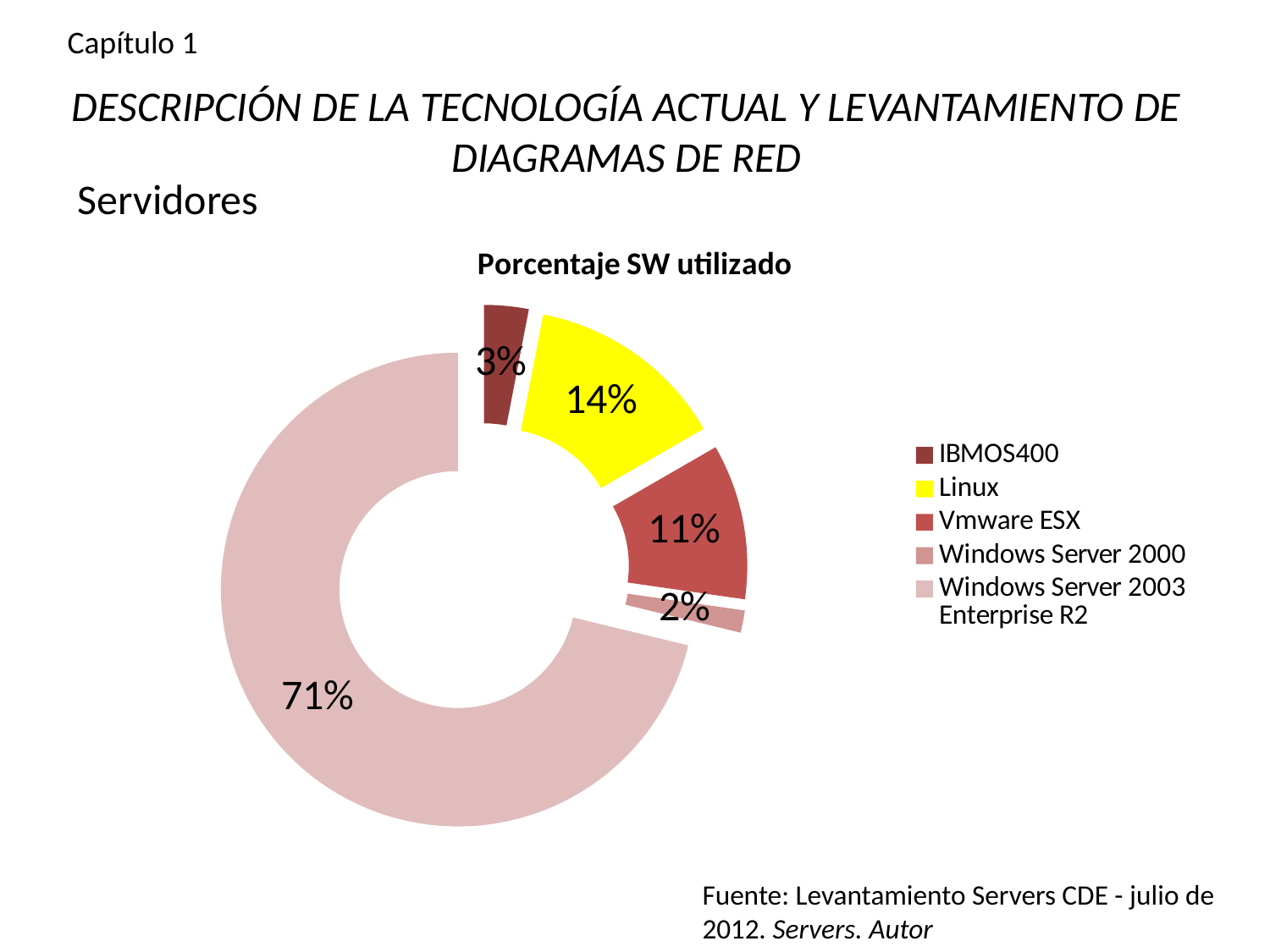
What is the title of the chart? Porcentaje SW utilizado What share of the pie does Windows Server 2003 Enterprise R2 have? 71% What share of the pie does Linux have? 14% Which is larger, the share for IBMOS400 or the share for Windows Server 2000? IBMOS400 What is the value shown for IBMOS400? 3% What is the difference between the shares of Linux and Vmware ESX? 3% What is the value shown for Windows Server 2000? 2% Which category has the largest share? Windows Server 2003 Enterprise R2 Which category has the smallest share? Windows Server 2000 How many categories does the chart show? 5 What kind of chart is shown on the slide? Pie chart (doughnut) What is the value shown for Vmware ESX? 11%